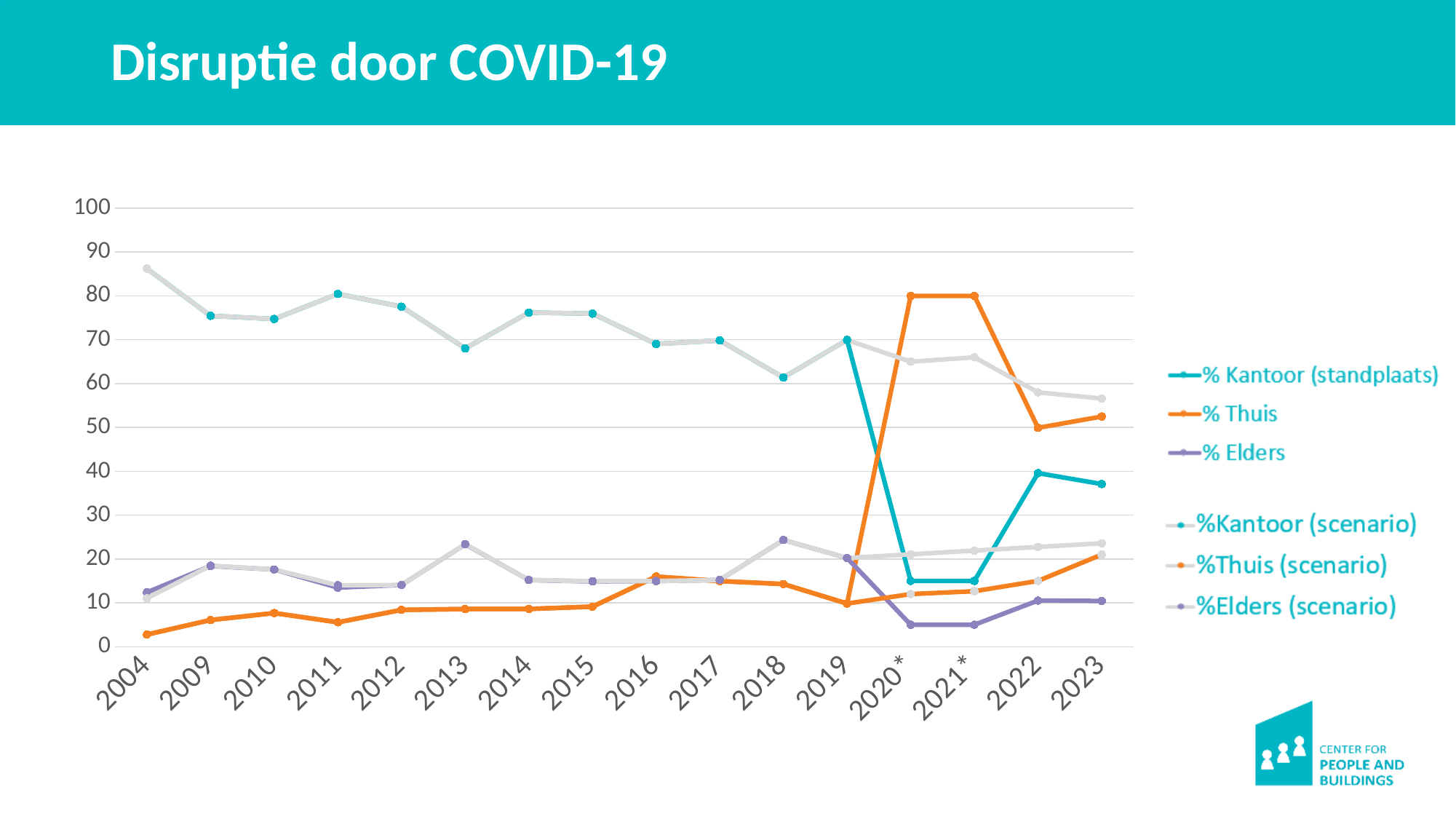
What kind of chart is shown on the slide? line chart In 2022, which is larger: % Thuis or % Kantoor (standplaats)? % Thuis Is the value for % Kantoor (standplaats) in 2004 greater or less than 80? greater Is the value for % Thuis in 2020* greater or less than 70? greater Which series has the lowest value in 2021*? % Elders Does the % Kantoor (standplaats) line generally rise or fall from 2004 to 2019? fall How many years are shown along the x axis? 16 Is the value for % Kantoor (standplaats) in 2020* greater or less than 20? less How many series does the legend list? 6 What is the title of the slide containing the chart? Disruptie door COVID-19 Which series has the highest value in 2021*? % Thuis